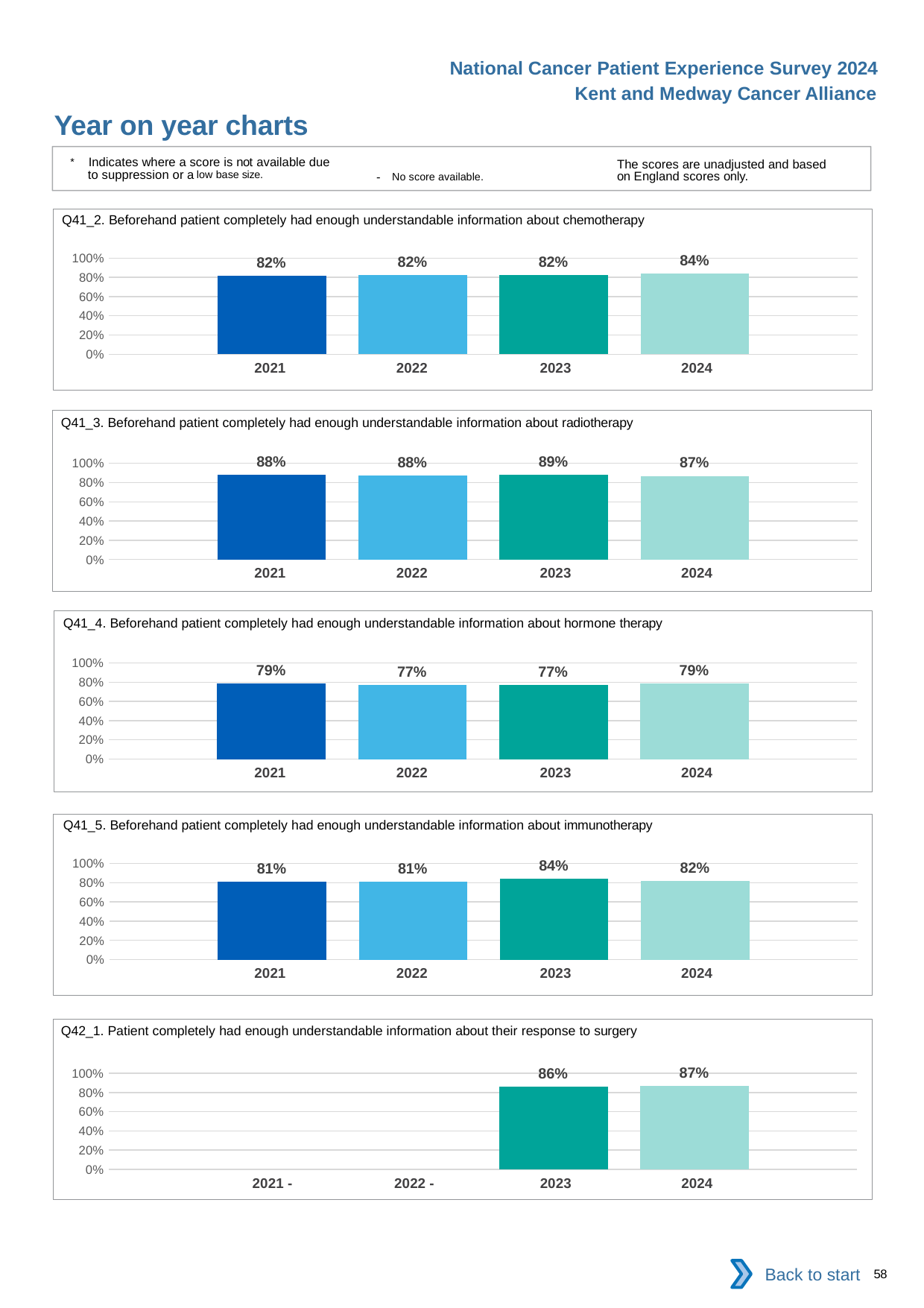
What kind of chart is the Q41_2 chart (chemotherapy)? Bar chart In the Q41_2 chart (chemotherapy), what is the value for 2024? 84% In the Q41_5 chart (immunotherapy), what is the value for 2021? 81% In the Q41_5 chart (immunotherapy), which year has the highest value? 2023 In the Q41_3 chart (radiotherapy), which year has the highest value? 2023 In the Q41_3 chart (radiotherapy), what is the value for 2024? 87% In the Q41_4 chart (hormone therapy), what is the difference between the 2021 and 2022 values? 2 percentage points In the Q41_4 chart (hormone therapy), which year has the lowest value, 2022 or 2024? 2022 In the Q42_1 chart (response to surgery), what is the value for 2023? 86% How many charts are shown on the slide? 5 In the Q42_1 chart (response to surgery), how many years have a bar plotted? 2 In the Q42_1 chart (response to surgery), is the value for 2024 greater or less than 80%? greater